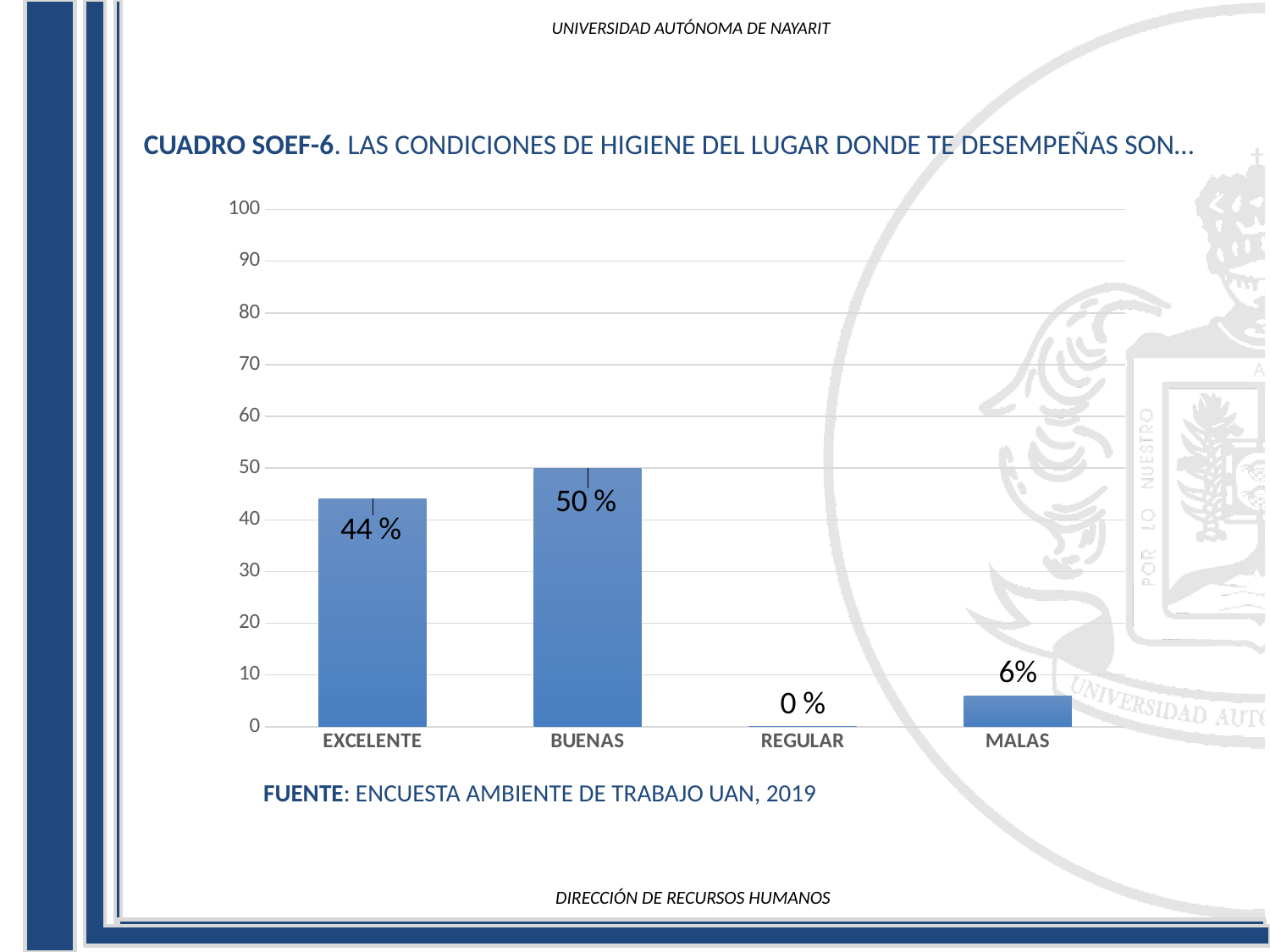
How many categories are shown on the x axis? 4 Which category has the lowest value? REGULAR What is the value for MALAS? 6% What kind of chart is shown on the slide? bar chart Which is larger, the value for EXCELENTE or the value for MALAS? EXCELENTE What is the difference between the values for BUENAS and EXCELENTE? 6 % Which category has the highest value? BUENAS What is the value for REGULAR? 0 % What is the value for BUENAS? 50 % What source is cited below the chart? ENCUESTA AMBIENTE DE TRABAJO UAN, 2019 Is the value for EXCELENTE greater or less than 40? greater What is the value for EXCELENTE? 44 %